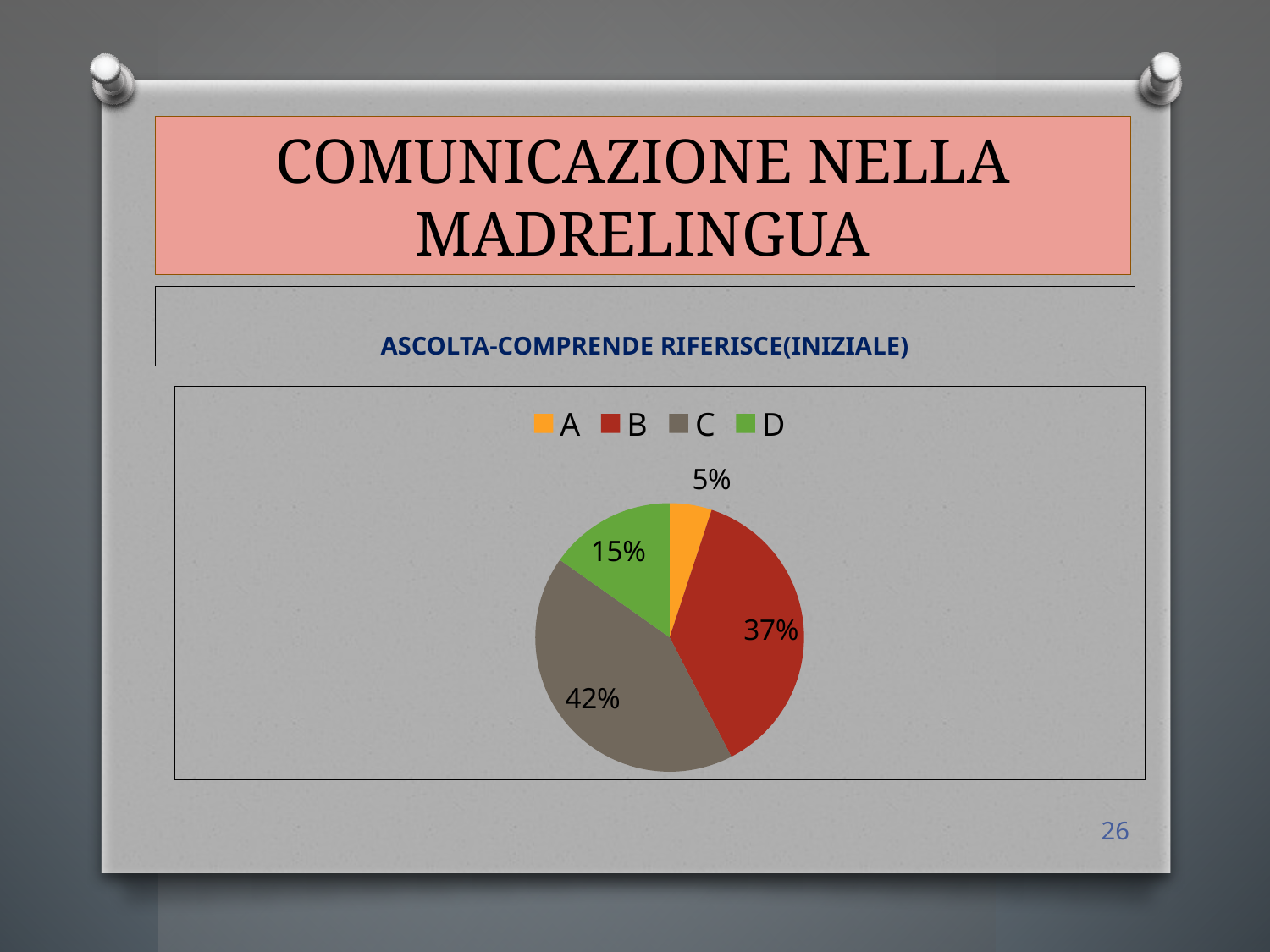
What is the value for category A in the pie chart? 5% What is the value for category B in the pie chart? 37% Which category has the largest slice of the pie chart? C Which is larger, the value for D or the value for A? D What colour is the slice for category B in the pie chart? red What is the difference between the values for C and B? 5% What is the title shown above the pie chart? ASCOLTA-COMPRENDE RIFERISCE(INIZIALE) Which category has the smallest slice of the pie chart? A How many categories does the legend of the pie chart list? 4 What type of chart is shown on the slide? pie chart What is the value for category C in the pie chart? 42% What is the value for category D in the pie chart? 15%